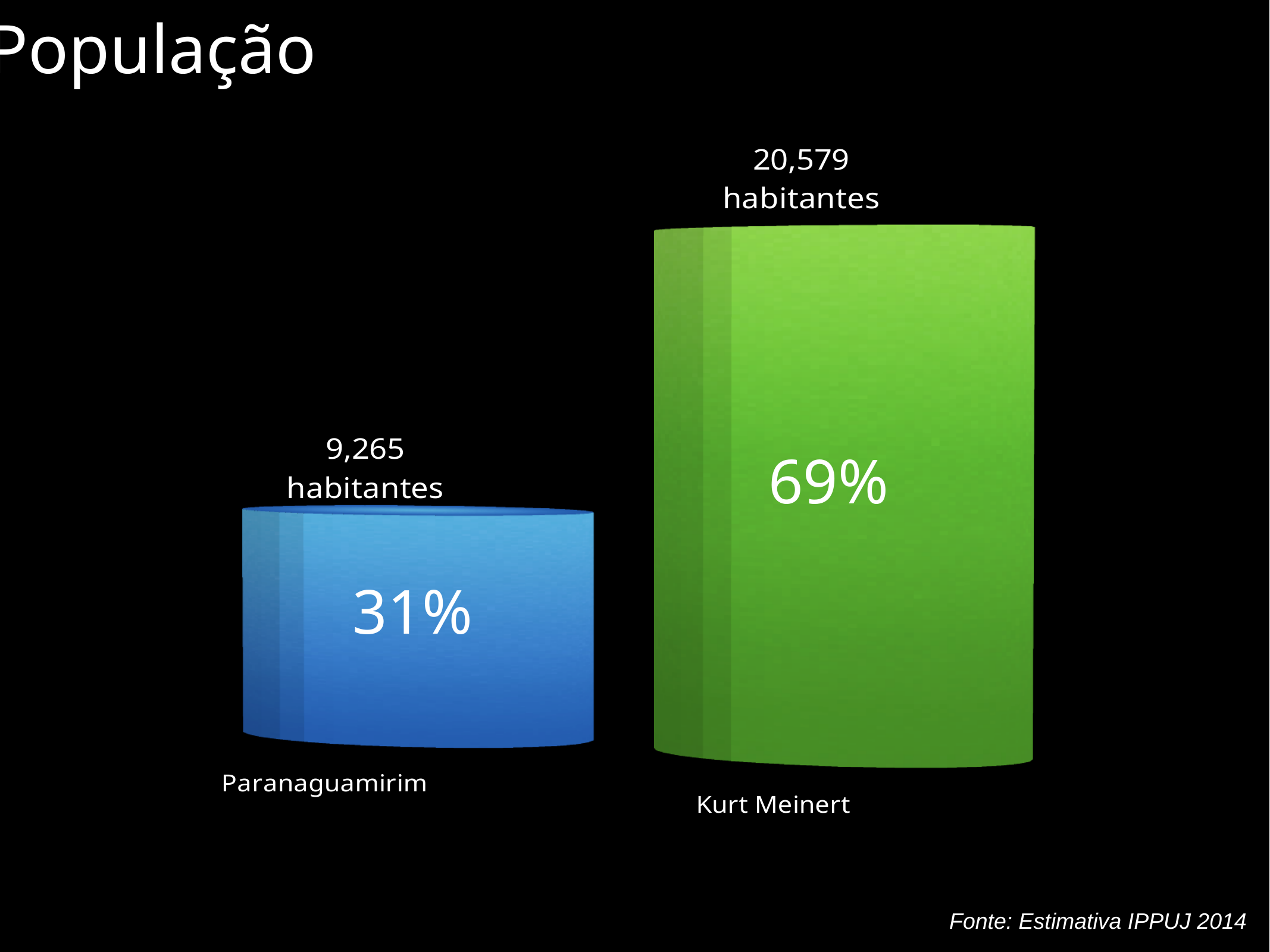
What is the population of Paranaguamirim? 9,265 habitantes How many categories are shown in the chart? 2 What colour is the Kurt Meinert bar? Green Which category has the highest population? Kurt Meinert What is the title of the slide? População Which has a larger population, Paranaguamirim or Kurt Meinert? Kurt Meinert Which category has the lowest population? Paranaguamirim What kind of chart is shown on the slide? Bar chart What percentage is shown on the Kurt Meinert bar? 69% What is the difference in population between Kurt Meinert and Paranaguamirim? 11,314 What percentage is shown on the Paranaguamirim bar? 31% What is the population of Kurt Meinert? 20,579 habitantes